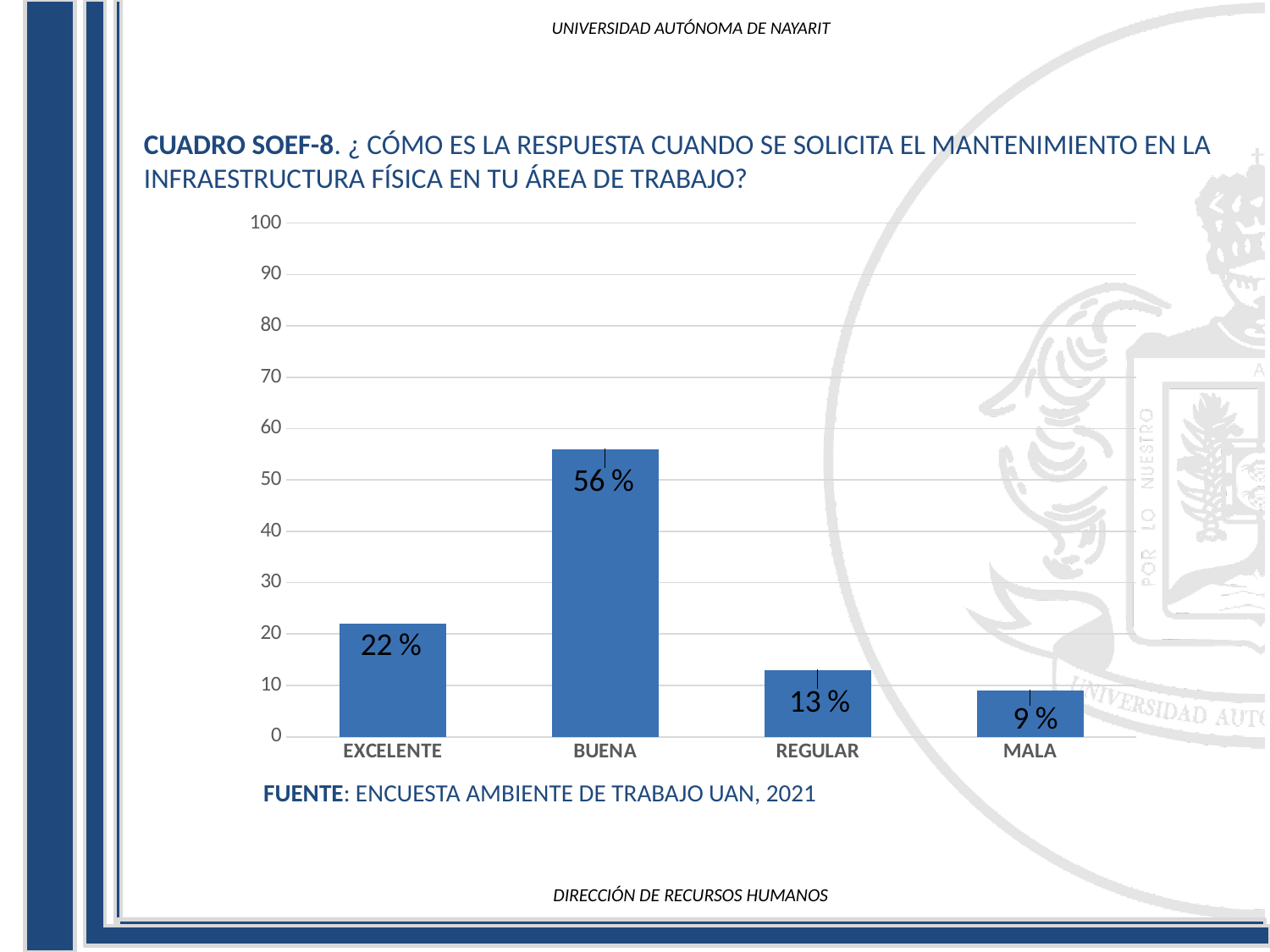
Is the value for BUENA greater or less than 50? greater Which category has the lowest value? MALA What source is cited below the chart? ENCUESTA AMBIENTE DE TRABAJO UAN, 2021 What is the value for MALA? 9 % What is the difference between the values for BUENA and EXCELENTE? 34 % Which is larger, the value for REGULAR or the value for MALA? REGULAR How many categories are shown on the x axis? 4 What is the value for EXCELENTE? 22 % What is the value for REGULAR? 13 % Which category has the highest value? BUENA What kind of chart is shown on the slide? bar chart What is the value for BUENA? 56 %